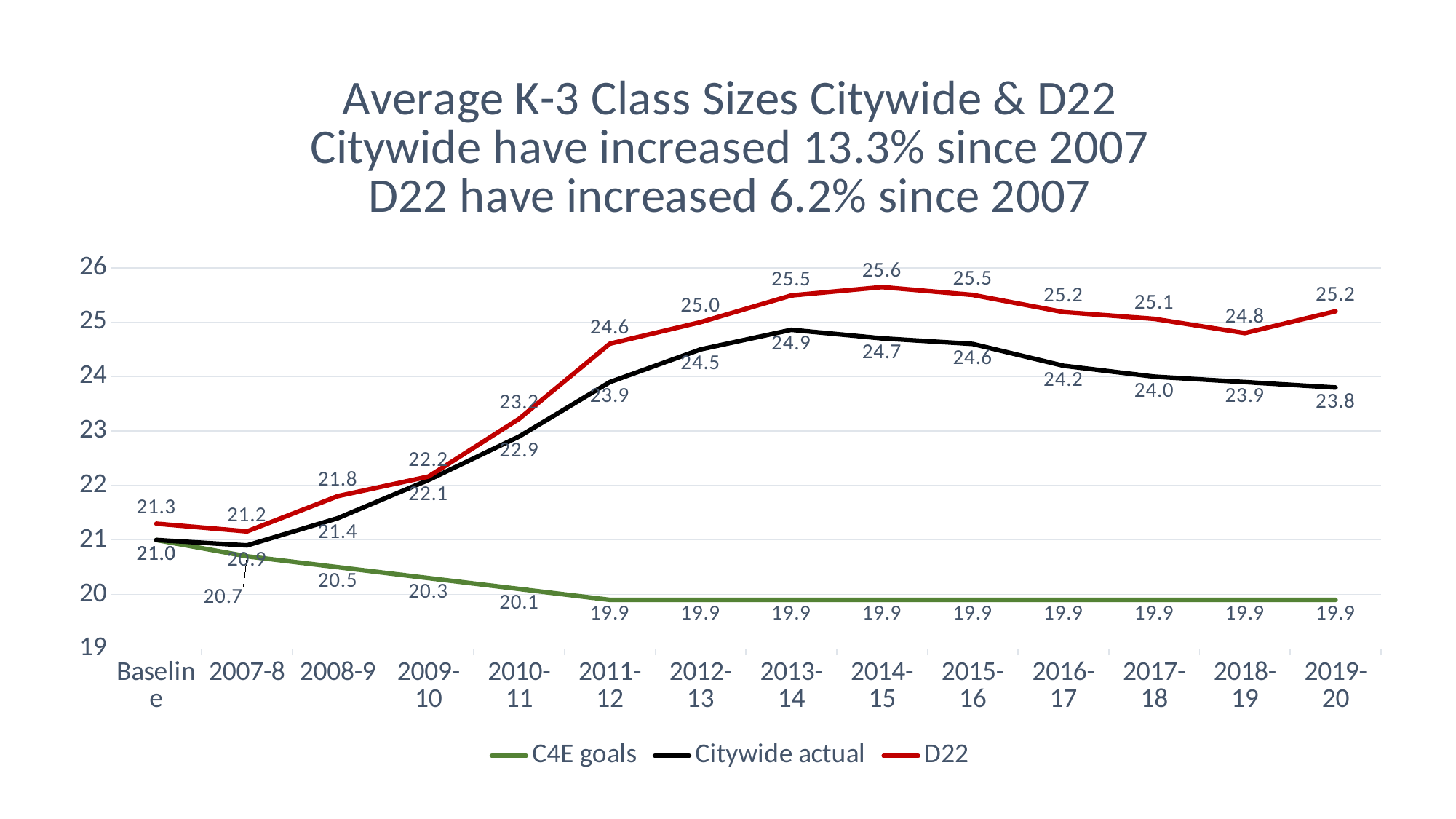
Do the C4E goals values rise or fall from Baseline to 2011-12? fall What is the difference between the D22 and Citywide actual values in 2019-20? 1.4 In 2011-12, which is larger: D22 or Citywide actual? D22 What is the Citywide actual value for 2013-14? 24.9 According to the chart title, by what percentage have Citywide class sizes increased since 2007? 13.3% How many series does the legend list? 3 In which year is the Citywide actual value lowest? 2007-8 What is the C4E goals value for 2019-20? 19.9 What type of chart is shown on the slide? line chart What is the D22 value for 2014-15? 25.6 In which year is the D22 value highest? 2014-15 How many categories are shown along the x axis? 14